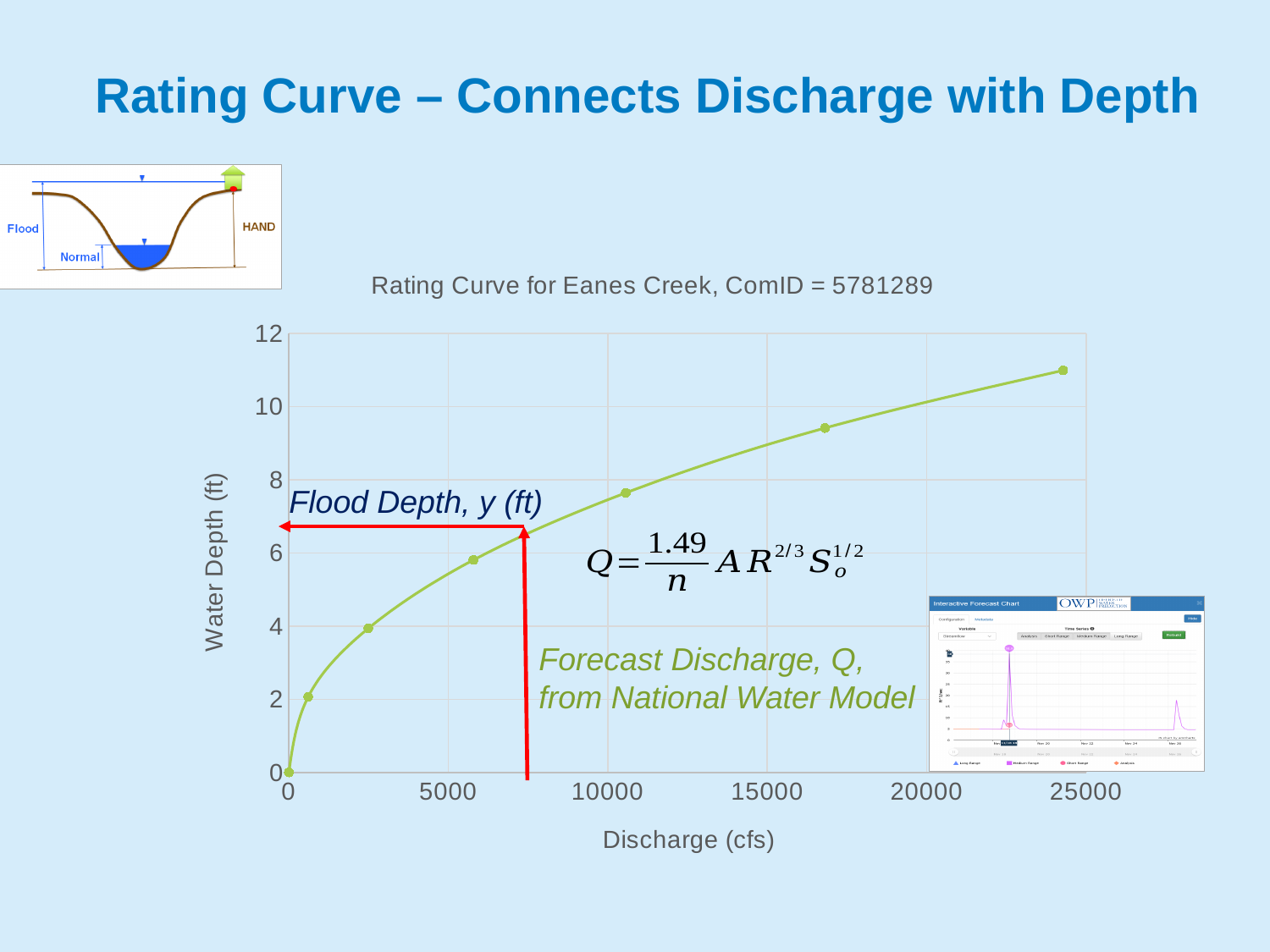
How many data points are plotted on the Rating Curve for Eanes Creek? 7 What ComID is given in the title of the Rating Curve for Eanes Creek? 5781289 On the Rating Curve for Eanes Creek, is the maximum water depth reached at the lowest or the highest discharge? highest discharge On the Rating Curve for Eanes Creek, is the water depth at the highest-discharge point greater or less than 10 ft? greater On the Rating Curve for Eanes Creek, is the water depth at a discharge of 10000 cfs greater or less than 6 ft? greater On the Rating Curve for Eanes Creek, is the water depth at a discharge of 5000 cfs greater or less than 4 ft? greater What kind of chart is the Rating Curve for Eanes Creek? line chart What is the y-axis title of the Rating Curve for Eanes Creek? Water Depth (ft) On the Rating Curve for Eanes Creek, does water depth rise or fall as discharge increases? rises